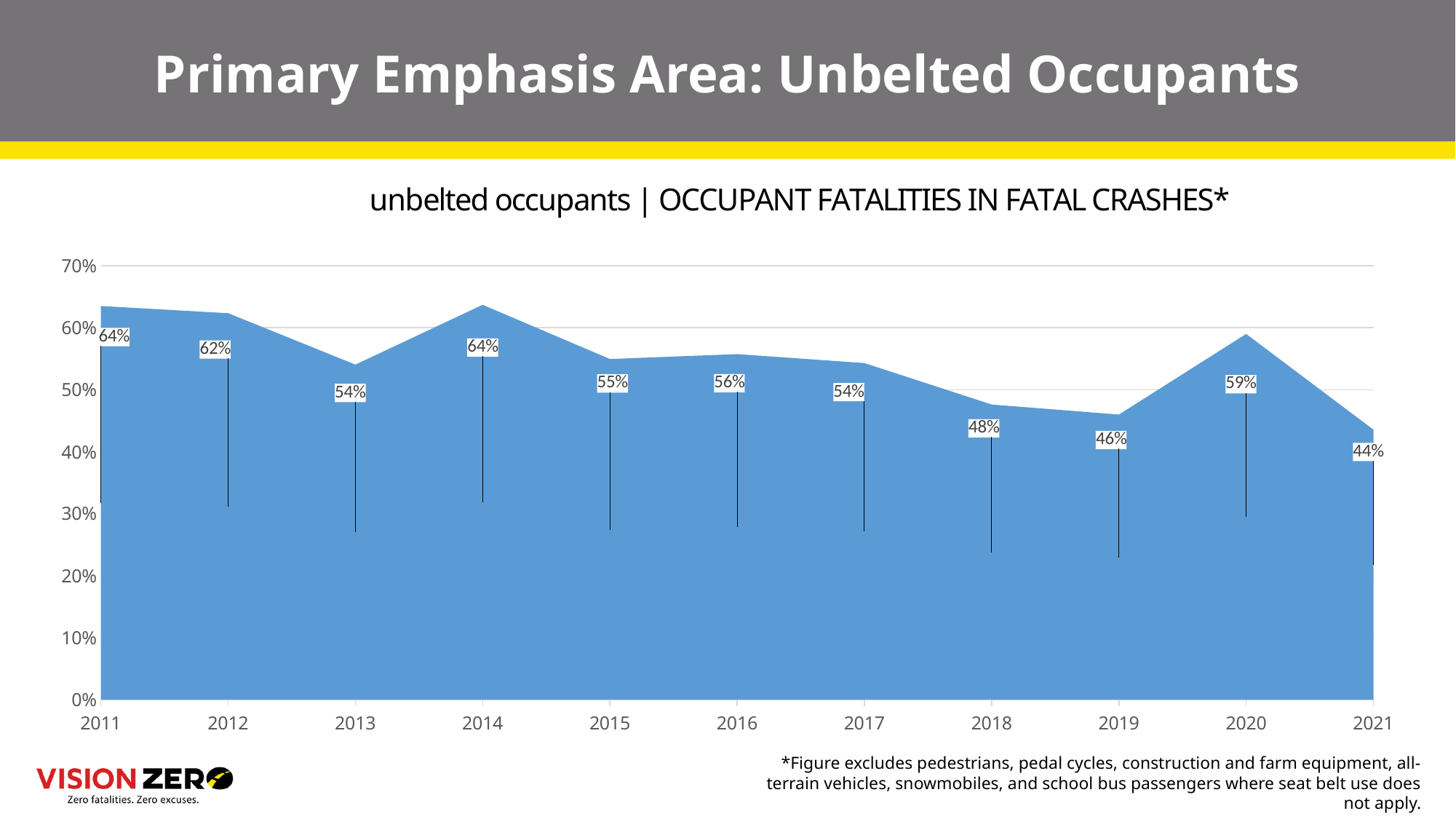
What kind of chart is shown on the slide? Area chart What is the value for 2021? 44% Which is larger, the value for 2013 or the value for 2020? 2020 What is the highest value shown on the chart? 64% What is the difference between the values for 2020 and 2021? 15% Which year has the lowest value? 2021 What is the title of the chart? unbelted occupants | OCCUPANT FATALITIES IN FATAL CRASHES* What is the value for 2020? 59% How many years are plotted on the chart? 11 What is the difference between the values for 2011 and 2019? 18% What is the value for 2018? 48% What is the value for 2016? 56%